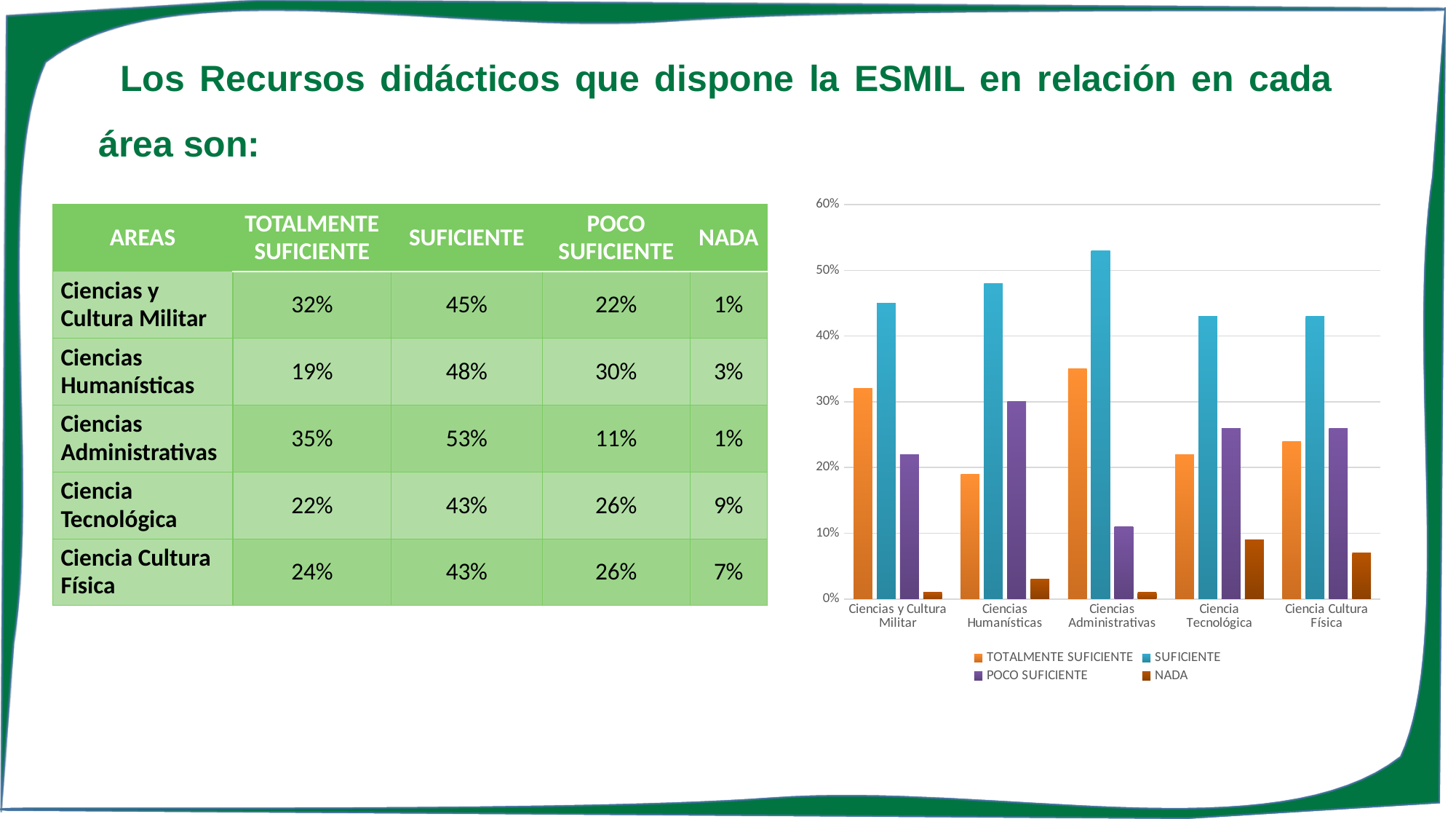
Which area has the lowest POCO SUFICIENTE value? Ciencias Administrativas Which area has the highest SUFICIENTE value? Ciencias Administrativas What is the SUFICIENTE value for Ciencias Administrativas? 53% What is the difference between the SUFICIENTE and TOTALMENTE SUFICIENTE values for Ciencias y Cultura Militar? 13% Which series in the chart is shown in orange? TOTALMENTE SUFICIENTE What is the NADA value for Ciencia Tecnológica? 9% What kind of chart is shown on the slide? bar chart How many series does the chart legend list? 4 Is the SUFICIENTE value for Ciencias Administrativas greater or less than 50%? greater What is the TOTALMENTE SUFICIENTE value for Ciencias Humanísticas? 19% How many areas (categories) are plotted on the x axis of the chart? 5 Which is larger for Ciencias Humanísticas: the POCO SUFICIENTE value or the TOTALMENTE SUFICIENTE value? POCO SUFICIENTE